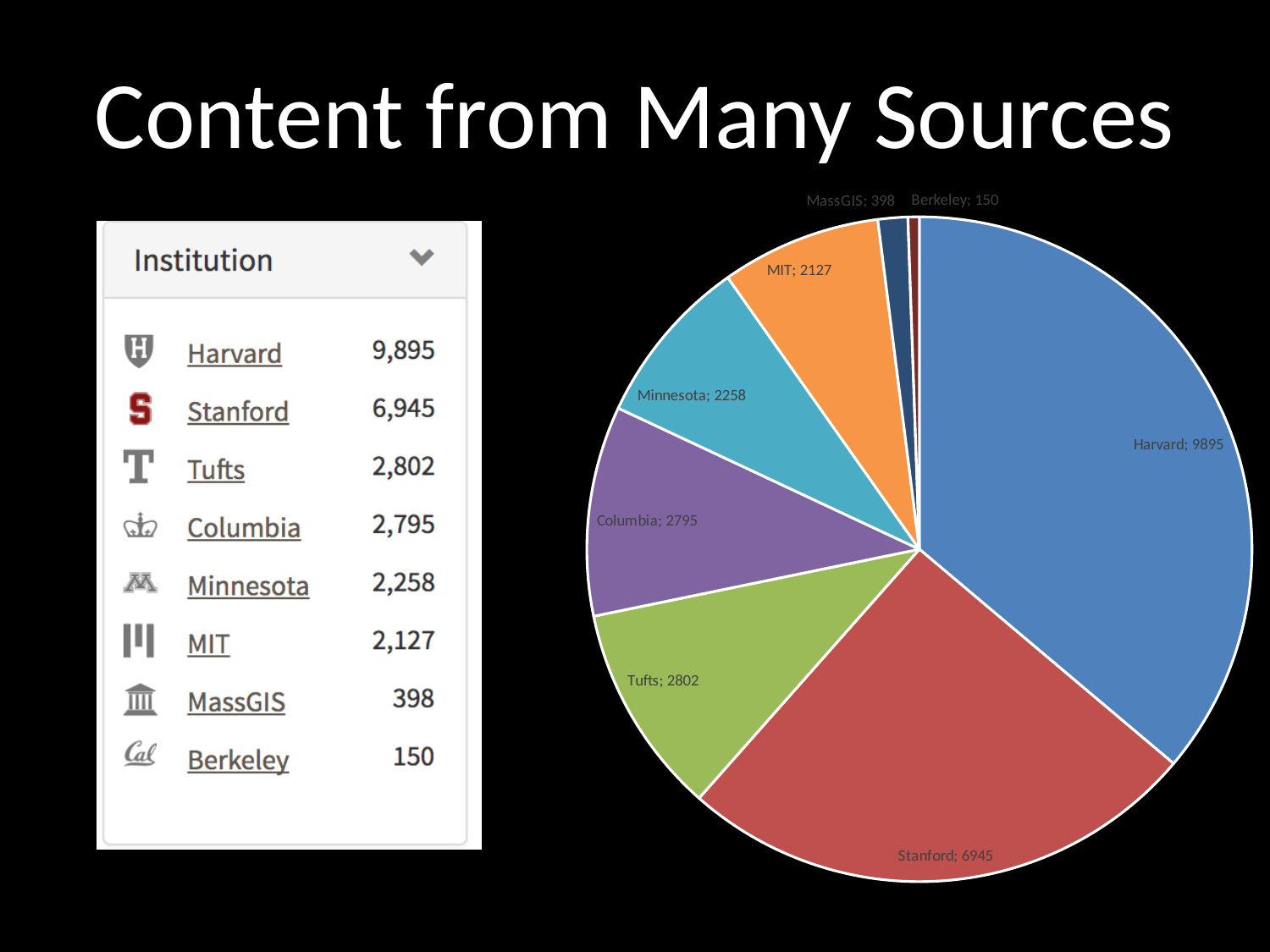
What is the value for Minnesota in the pie chart? 2258 Which institution has the largest slice in the pie chart? Harvard What is the difference between the values for Harvard and Stanford in the pie chart? 2950 Which is larger in the pie chart, the value for Stanford or the value for Tufts? Stanford What is the difference between the values for Minnesota and MIT in the pie chart? 131 How many slices does the pie chart have? 8 What kind of chart is shown on the slide? pie chart What is the value for MassGIS in the pie chart? 398 What colour is the Harvard slice in the pie chart? blue Which institution has the smallest slice in the pie chart? Berkeley What is the value for Harvard in the pie chart? 9895 What is the value for Stanford in the pie chart? 6945